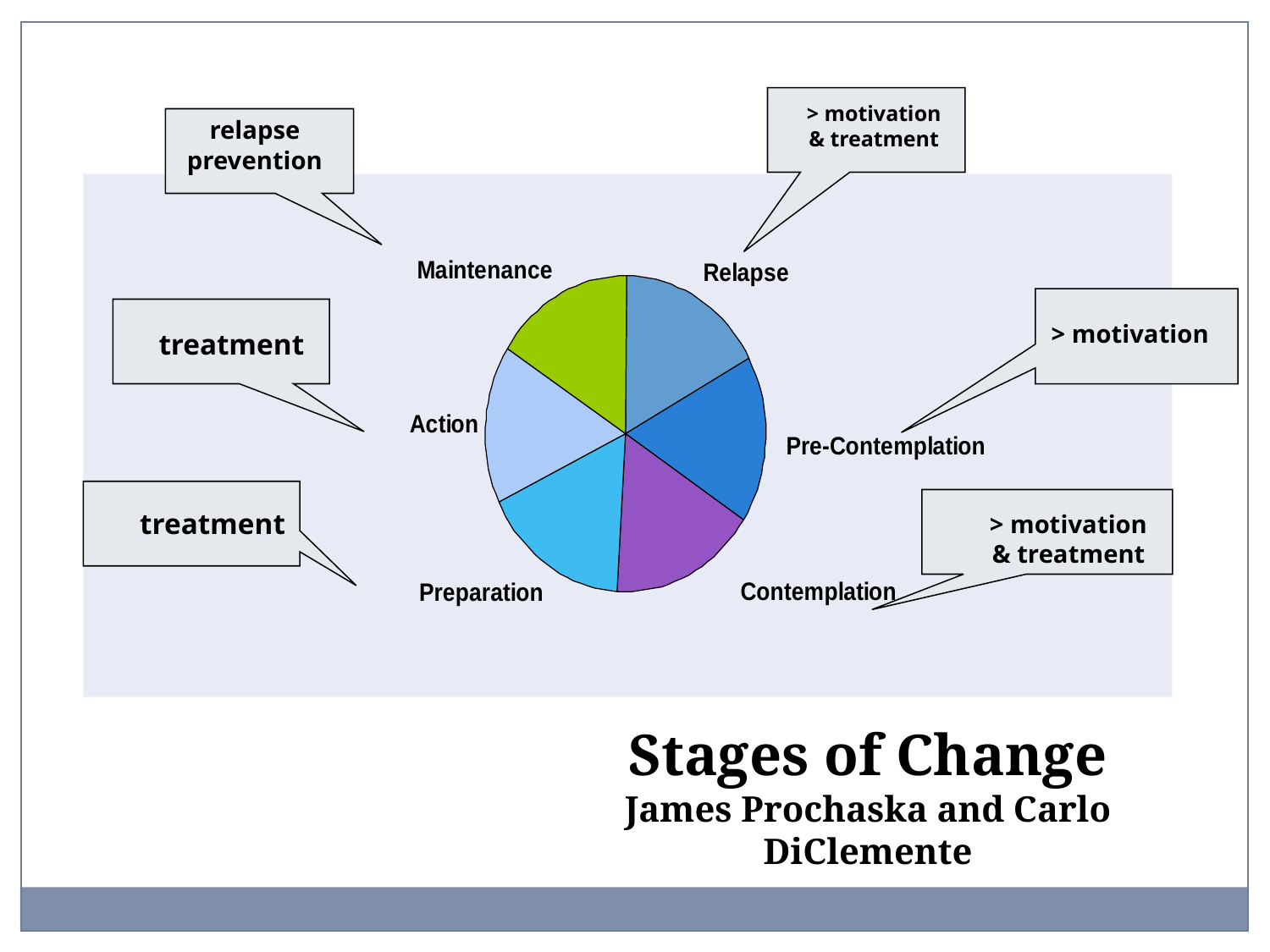
Which stage label appears at the left of the pie chart, next to the pale blue slice? Action What is the title printed below the chart area? Stages of Change What colour is the Maintenance slice of the pie chart? green Which stage label appears at the bottom left of the pie chart, next to the cyan slice? Preparation How many slices does the pie chart have? 6 Which stage label appears at the bottom right of the pie chart, next to the purple slice? Contemplation What kind of chart is shown on the slide? pie chart Which stage label appears at the top right of the pie chart? Relapse Which stage is labelled directly to the right of the pie chart, next to the dark blue slice? Pre-Contemplation